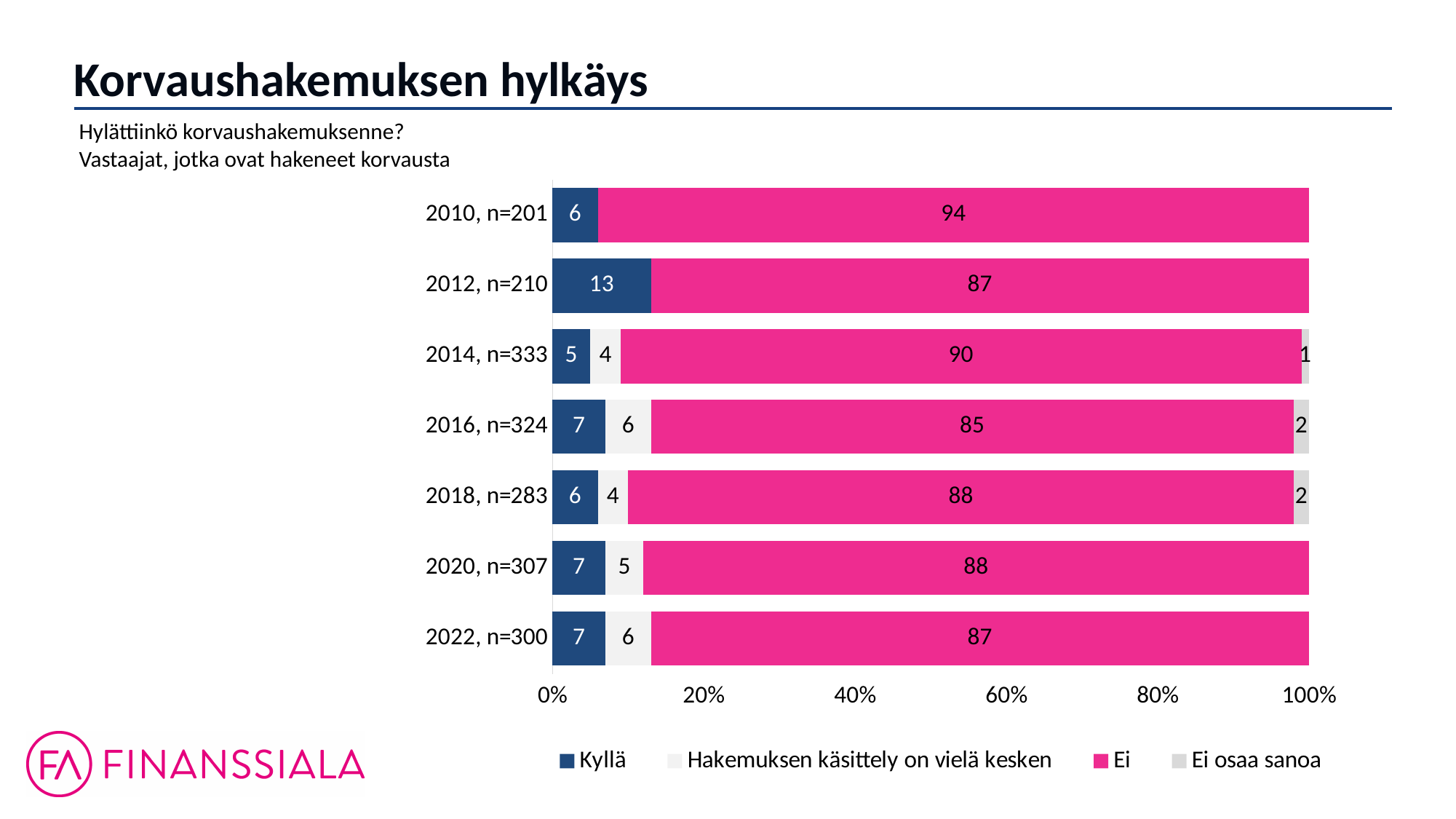
Which has the larger Kyllä value, 2010, n=201 or 2012, n=210? 2012, n=210 What kind of chart is shown on the slide? Stacked bar chart What is the difference between the Ei value for 2010, n=201 and the Ei value for 2022, n=300? 7 What is the value of 'Hakemuksen käsittely on vielä kesken' for 2016, n=324? 6 What is the title of the slide? Korvaushakemuksen hylkäys What is the value of Ei for 2010, n=201? 94 Which year has the lowest Ei value? 2016, n=324 What is the value of 'Ei osaa sanoa' for 2014, n=333? 1 How many years (categories) are shown in the chart? 7 How many series does the legend list? 4 What is the value of Kyllä for 2012, n=210? 13 Which year has the highest Kyllä value? 2012, n=210